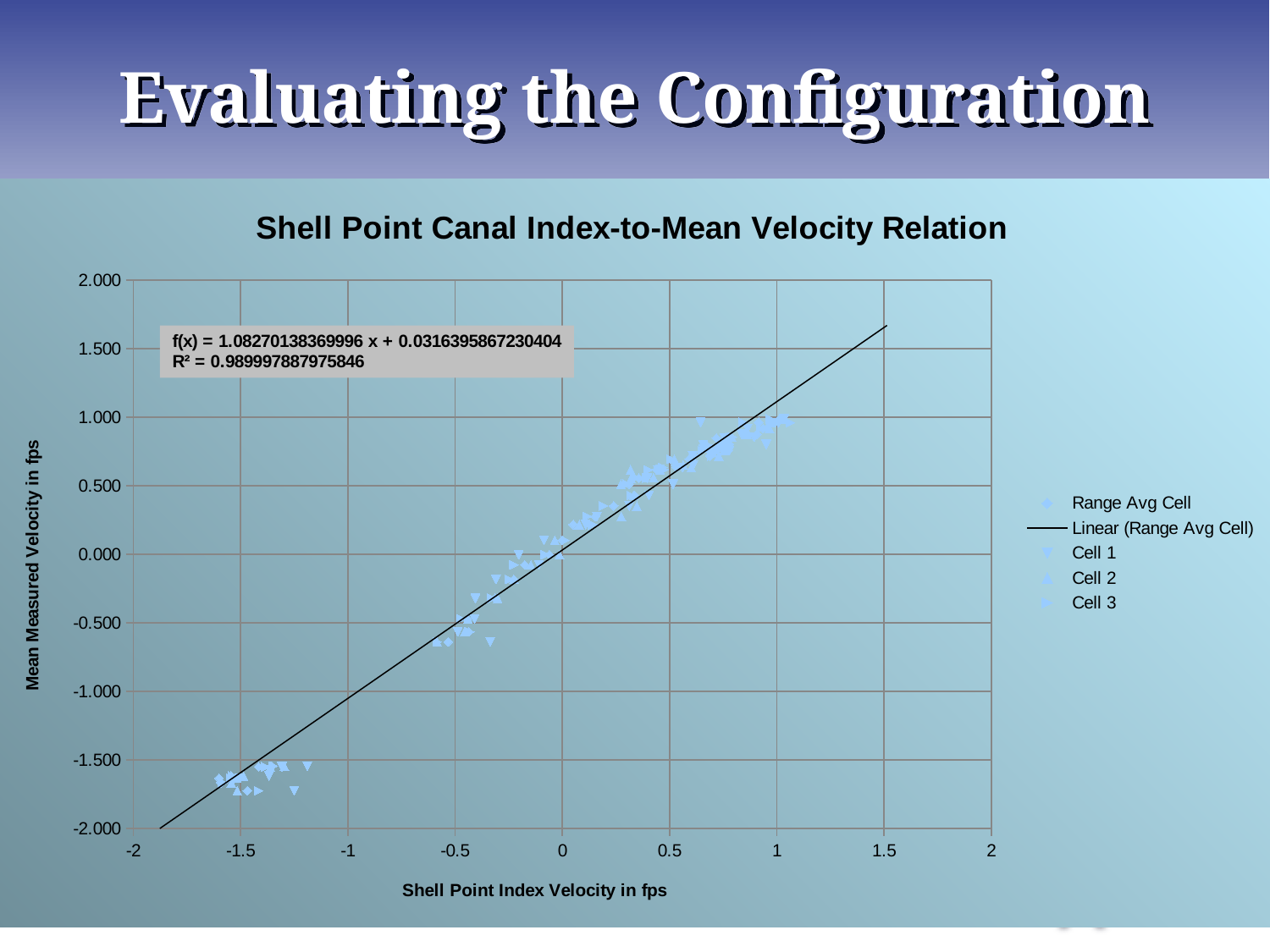
What kind of chart is shown on the slide? scatter chart Are the plotted Mean Measured Velocity values near an index velocity of -0.5 greater or less than 0.000? less Do the plotted values rise or fall as the Shell Point Index Velocity increases along the x axis? rise What is the title of the chart? Shell Point Canal Index-to-Mean Velocity Relation Are the plotted Mean Measured Velocity values near an index velocity of 0.5 greater or less than 0.000? greater Are the plotted Mean Measured Velocity values near an index velocity of -1.5 greater or less than -1.000? less How many entries does the legend list? 5 What R² value is printed on the chart? R² = 0.989997887975846